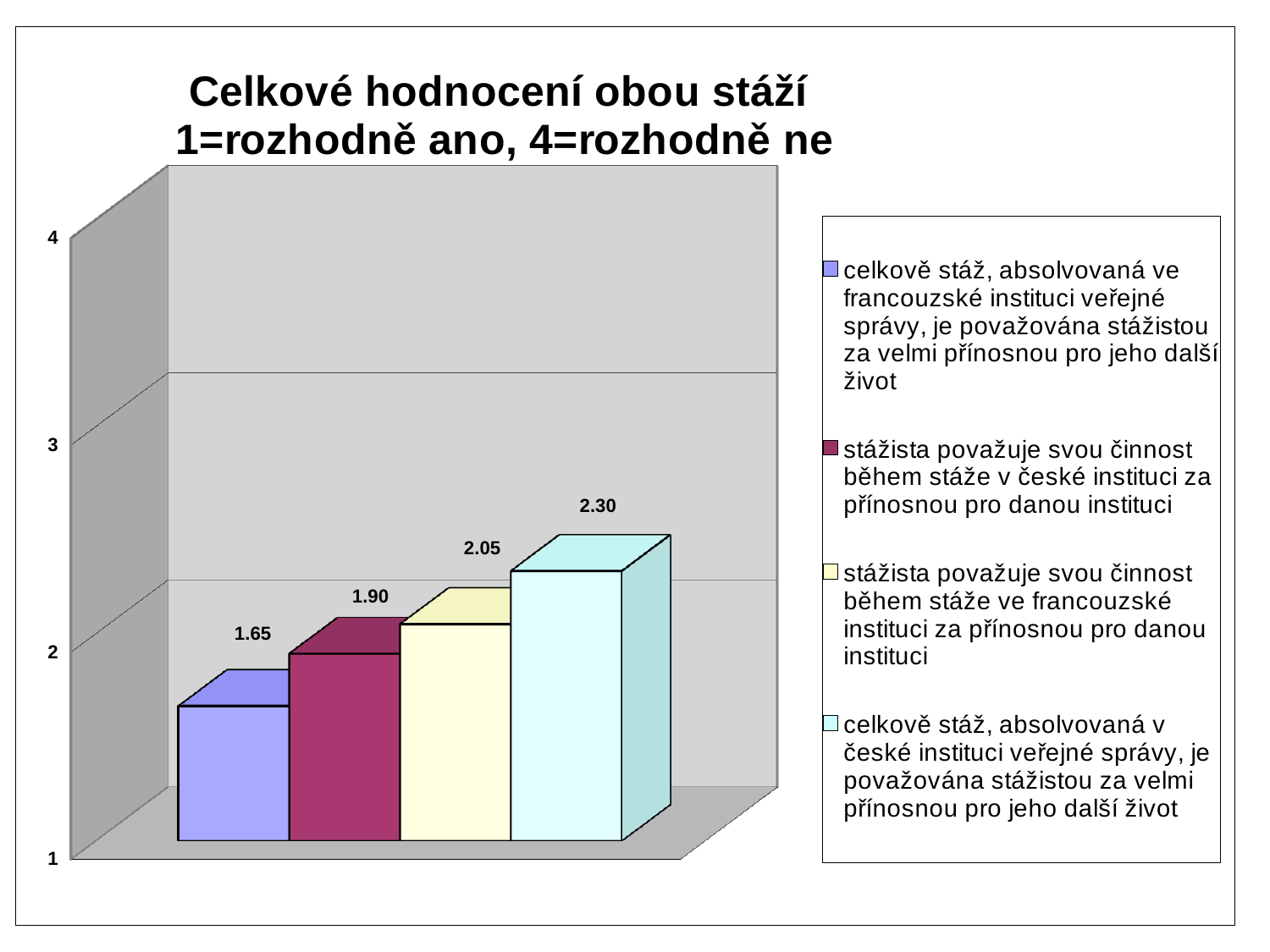
What is the value for the series "stážista považuje svou činnost během stáže v české instituci za přínosnou pro danou instituci"? 1.90 What is the difference between the highest value (2.30) and the lowest value (1.65)? 0.65 What is the value for the series "celkově stáž, absolvovaná ve francouzské instituci veřejné správy, je považována stážistou za velmi přínosnou pro jeho další život"? 1.65 What type of chart is shown on the slide? bar chart Which series has the lowest value? celkově stáž, absolvovaná ve francouzské instituci veřejné správy, je považována stážistou za velmi přínosnou pro jeho další život Is the value for the series "celkově stáž, absolvovaná v české instituci veřejné správy, je považována stážistou za velmi přínosnou pro jeho další život" greater or less than 3? less What is the value for the series "celkově stáž, absolvovaná v české instituci veřejné správy, je považována stážistou za velmi přínosnou pro jeho další život"? 2.30 What is the title of the chart? Celkové hodnocení obou stáží 1=rozhodně ano, 4=rozhodně ne Which is larger: the value for the stay in the Czech institution being beneficial for the institution (1.90) or the value for the stay in the French institution being beneficial for the institution (2.05)? stážista považuje svou činnost během stáže ve francouzské instituci za přínosnou pro danou instituci What is the value for the series "stážista považuje svou činnost během stáže ve francouzské instituci za přínosnou pro danou instituci"? 2.05 Which series has the highest value? celkově stáž, absolvovaná v české instituci veřejné správy, je považována stážistou za velmi přínosnou pro jeho další život How many series does the legend list? 4